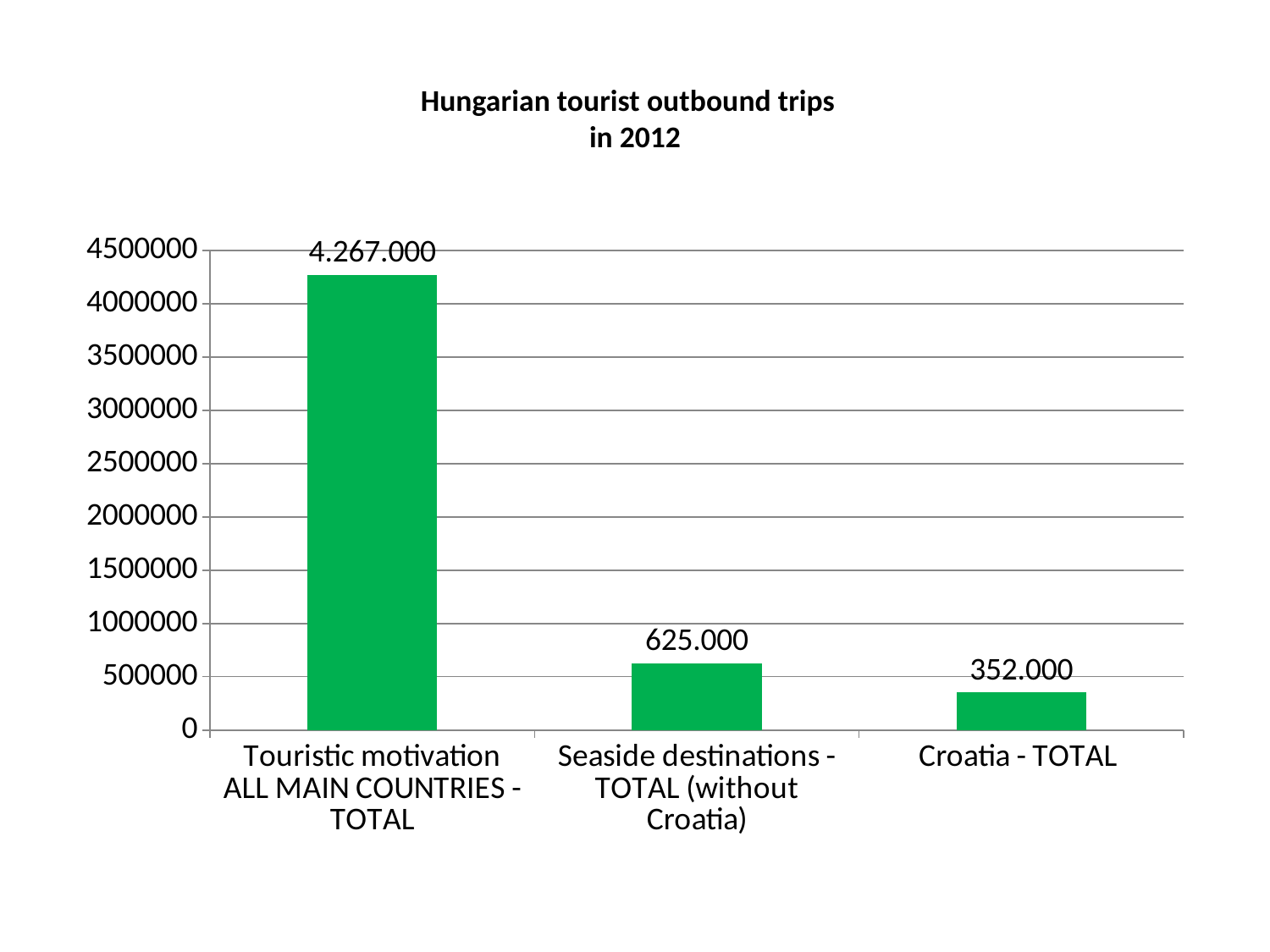
How many categories are shown in the chart? 3 What is the title of the chart? Hungarian tourist outbound trips in 2012 What is the difference between the values for Seaside destinations - TOTAL (without Croatia) and Croatia - TOTAL? 273.000 Which category has the highest value? Touristic motivation ALL MAIN COUNTRIES - TOTAL Which category has the lowest value? Croatia - TOTAL Is the value for Croatia - TOTAL greater or less than 500000? less What kind of chart is shown on the slide? bar chart What is the value for Touristic motivation ALL MAIN COUNTRIES - TOTAL? 4.267.000 Which is larger, the value for Seaside destinations - TOTAL (without Croatia) or the value for Croatia - TOTAL? Seaside destinations - TOTAL (without Croatia) What is the value for Seaside destinations - TOTAL (without Croatia)? 625.000 What is the value for Croatia - TOTAL? 352.000 What is the difference between the values for Touristic motivation ALL MAIN COUNTRIES - TOTAL and Seaside destinations - TOTAL (without Croatia)? 3.642.000